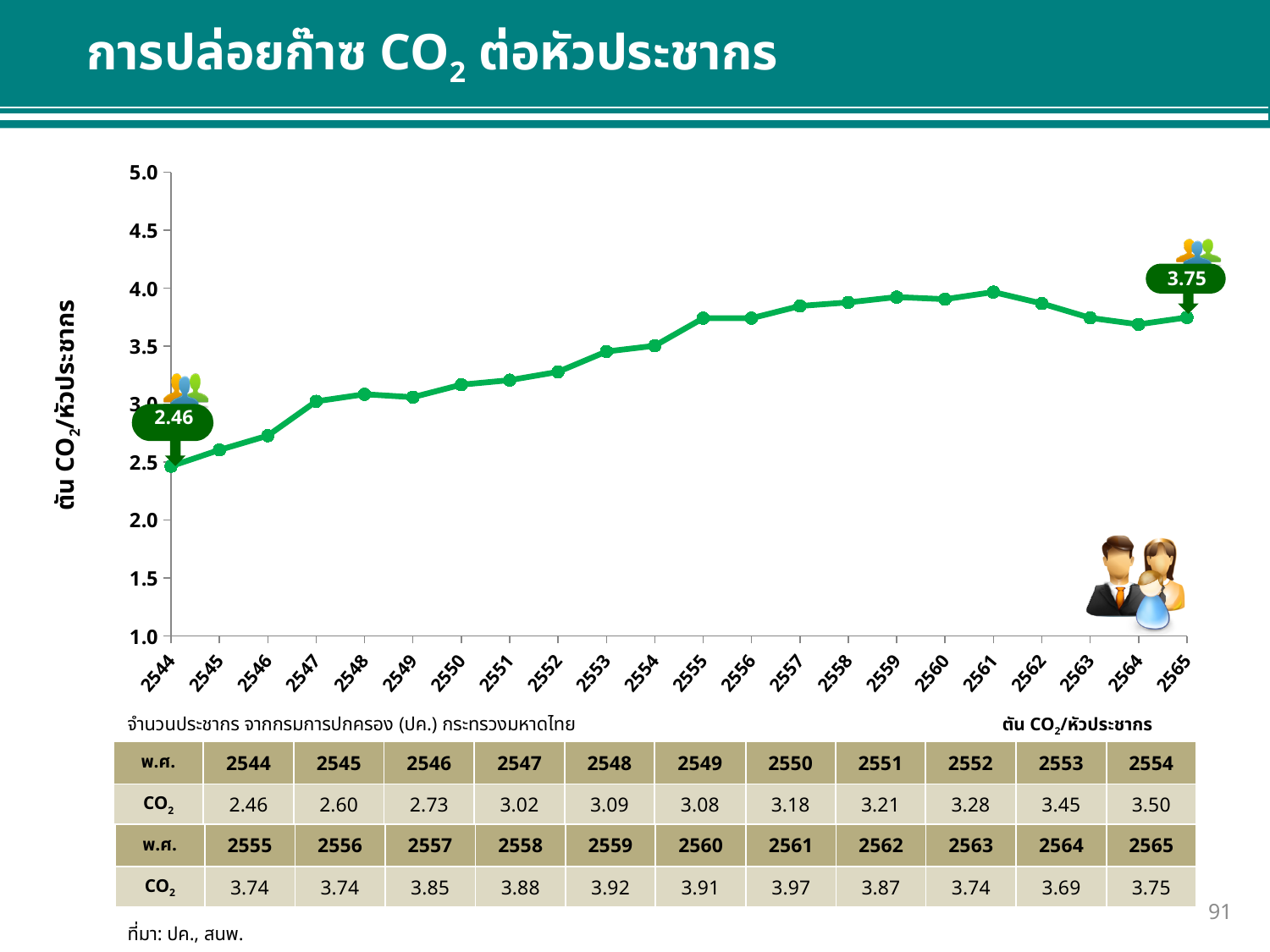
What is the CO2 emission per capita value for the year 2544? 2.46 What type of chart is shown on the slide? line chart What unit is shown on the y axis of the chart? ตัน CO2/หัวประชากร How many years are plotted on the x axis of the chart? 22 Which year has the lowest CO2 emission per capita? 2544 What is the difference between the CO2 emission per capita in 2565 and in 2544? 1.29 Is the CO2 emission per capita for 2559 greater or less than 3.5? greater What is the CO2 emission per capita value for the year 2565? 3.75 What is the CO2 emission per capita value for the year 2561? 3.97 Which year has a higher CO2 emission per capita, 2547 or 2555? 2555 Which year has the highest CO2 emission per capita? 2561 What is the overall trend of CO2 emission per capita from 2544 to 2561? rising